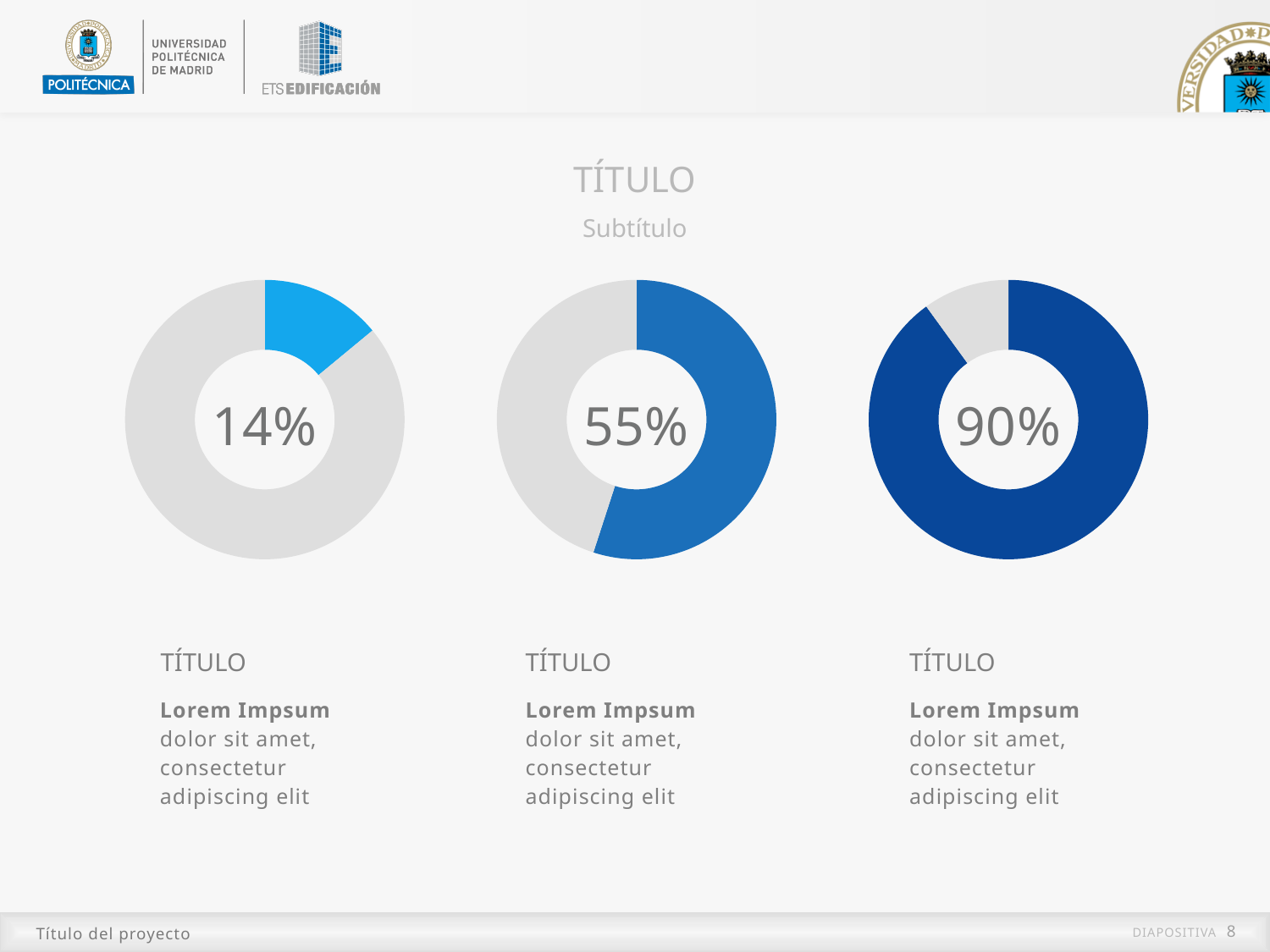
Which shows a larger percentage, the left donut chart or the middle donut chart? Middle Which donut chart shows the highest percentage: left, middle or right? Right Which donut chart shows the lowest percentage: left, middle or right? Left What kind of chart is used for the three figures on the slide? Donut chart What is the difference in percentage points between the right donut chart and the left donut chart? 76 What share of the right donut chart is filled with the dark blue colour? 90% What is the difference in percentage points between the middle donut chart and the left donut chart? 41 What percentage is shown in the centre of the right donut chart? 90% How many donut charts are on the slide? 3 What percentage is shown in the centre of the left donut chart? 14% What percentage is shown in the centre of the middle donut chart? 55% How many segments does each donut chart have? 2